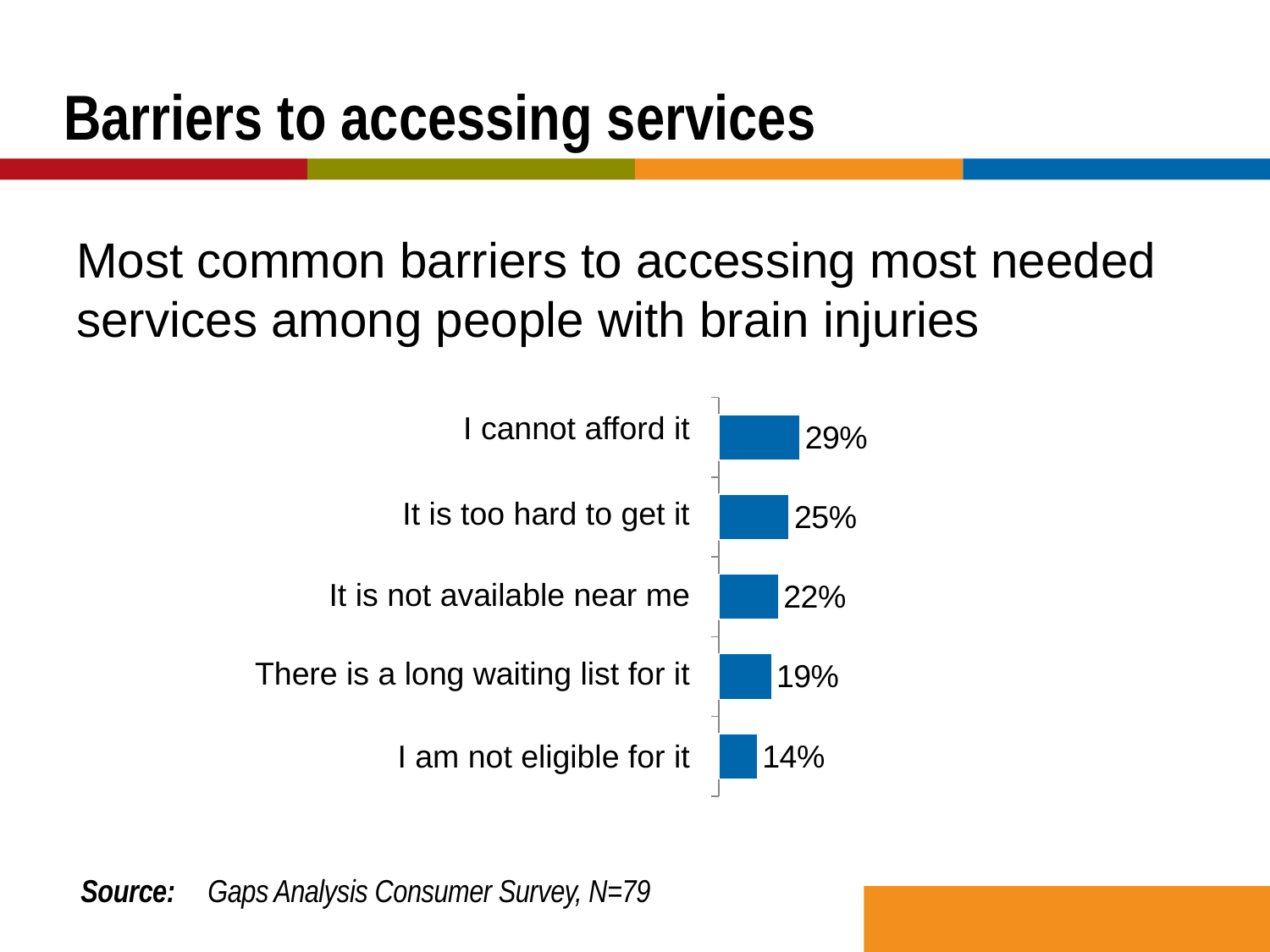
How many barriers are shown in the chart? 5 What is the value for "It is too hard to get it"? 25% What is the difference between "It is not available near me" and "There is a long waiting list for it"? 3 percentage points What is the difference in percentage points between "I cannot afford it" and "I am not eligible for it"? 15 percentage points Which is larger: the value for "It is too hard to get it" or "It is not available near me"? It is too hard to get it Which barrier has the highest percentage? I cannot afford it What percentage of respondents said "I cannot afford it"? 29% What kind of chart is shown on the slide? Bar chart What is the value for "I am not eligible for it"? 14% What is the value for "There is a long waiting list for it"? 19% Which barrier has the lowest percentage? I am not eligible for it What is the source of the data shown in the chart? Gaps Analysis Consumer Survey, N=79